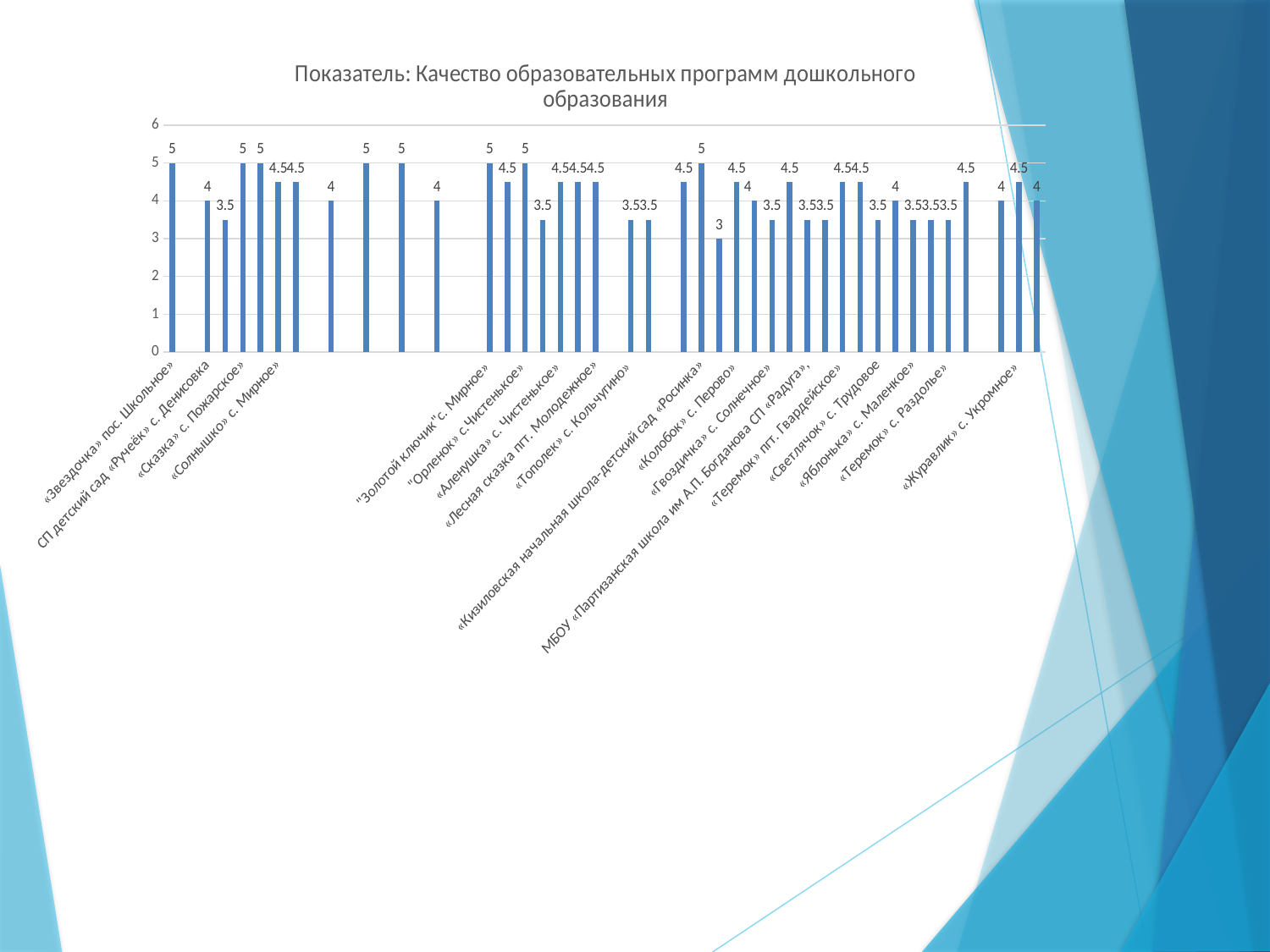
What is the lowest value shown by any bar on the chart? 3 What is the difference between the values for «Звездочка» пос. Школьное and СП детский сад «Ручеёк» с. Денисовка? 1 What is the value for «Журавлик» с. Укромное? 4.5 Which has the larger value, «Звездочка» пос. Школьное or СП детский сад «Ручеёк» с. Денисовка? «Звездочка» пос. Школьное Is the value for «Тополек» с. Кольчугино greater or less than 4? less What is the value for СП детский сад «Ручеёк» с. Денисовка? 4 What is the value for «Звездочка» пос. Школьное? 5 What is the value for «Солнышко» с. Мирное? 4.5 What kind of chart is shown on the slide? bar chart What is the value for «Тополек» с. Кольчугино? 3.5 What is the highest value shown by any bar on the chart? 5 What is the title of the chart? Показатель: Качество образовательных программ дошкольного образования